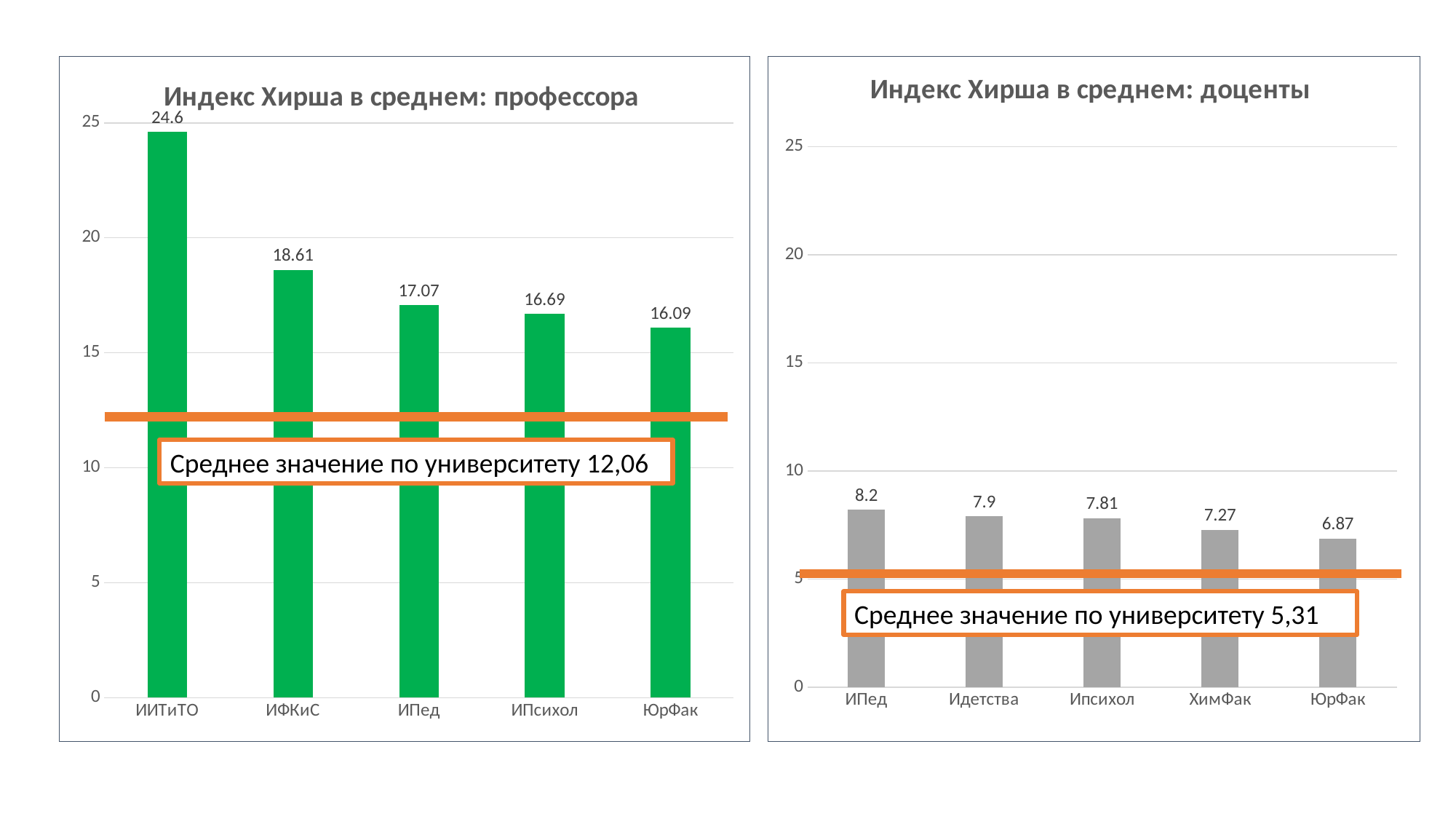
In the chart "Индекс Хирша в среднем: профессора", which category has the lowest value? ЮрФак What university-wide average value is stated in the text box on the chart "Индекс Хирша в среднем: доценты"? 5,31 In the chart "Индекс Хирша в среднем: доценты", which is larger, the value for ХимФак or the value for ЮрФак? ХимФак In the chart "Индекс Хирша в среднем: профессора", do the values rise or fall from left to right? fall In the chart "Индекс Хирша в среднем: профессора", how many categories are shown? 5 In the chart "Индекс Хирша в среднем: профессора", what is the difference between the values for ИИТиТО and ИФКиС? 5.99 In the chart "Индекс Хирша в среднем: профессора", what is the value for ИИТиТО? 24.6 In the chart "Индекс Хирша в среднем: профессора", what is the value for ИПсихол? 16.69 In the chart "Индекс Хирша в среднем: доценты", which category has the highest value? ИПед In the chart "Индекс Хирша в среднем: доценты", what is the difference between the values for ИПед and ЮрФак? 1.33 What kind of chart is "Индекс Хирша в среднем: доценты"? bar chart In the chart "Индекс Хирша в среднем: доценты", what is the value for Идетства? 7.9